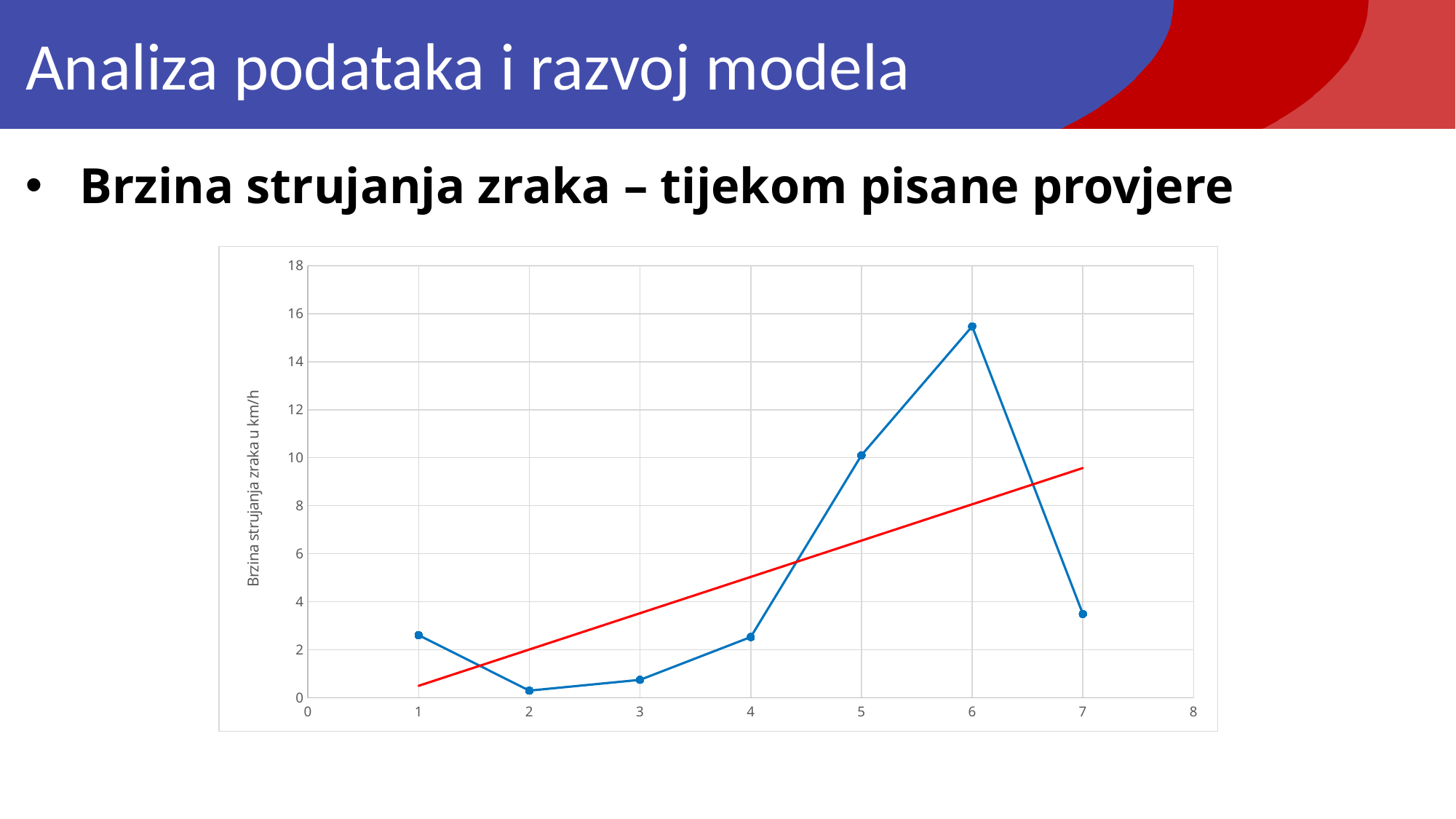
Which is larger, the value at x = 5 or the value at x = 4? x = 5 Is the value at x = 6 greater or less than 14? greater At which x value does the blue line reach its highest point? 6 What kind of chart is shown on the slide? line chart What is the label on the vertical axis? Brzina strujanja zraka u km/h What colour is the straight trend line drawn across the chart? red At which x value does the blue line reach its lowest point? 2 Do the values on the blue line rise or fall between x = 2 and x = 6? rise Is the value at x = 5 greater or less than 8? greater How many data points are plotted on the blue line? 7 Is the value at x = 2 greater or less than 2? less